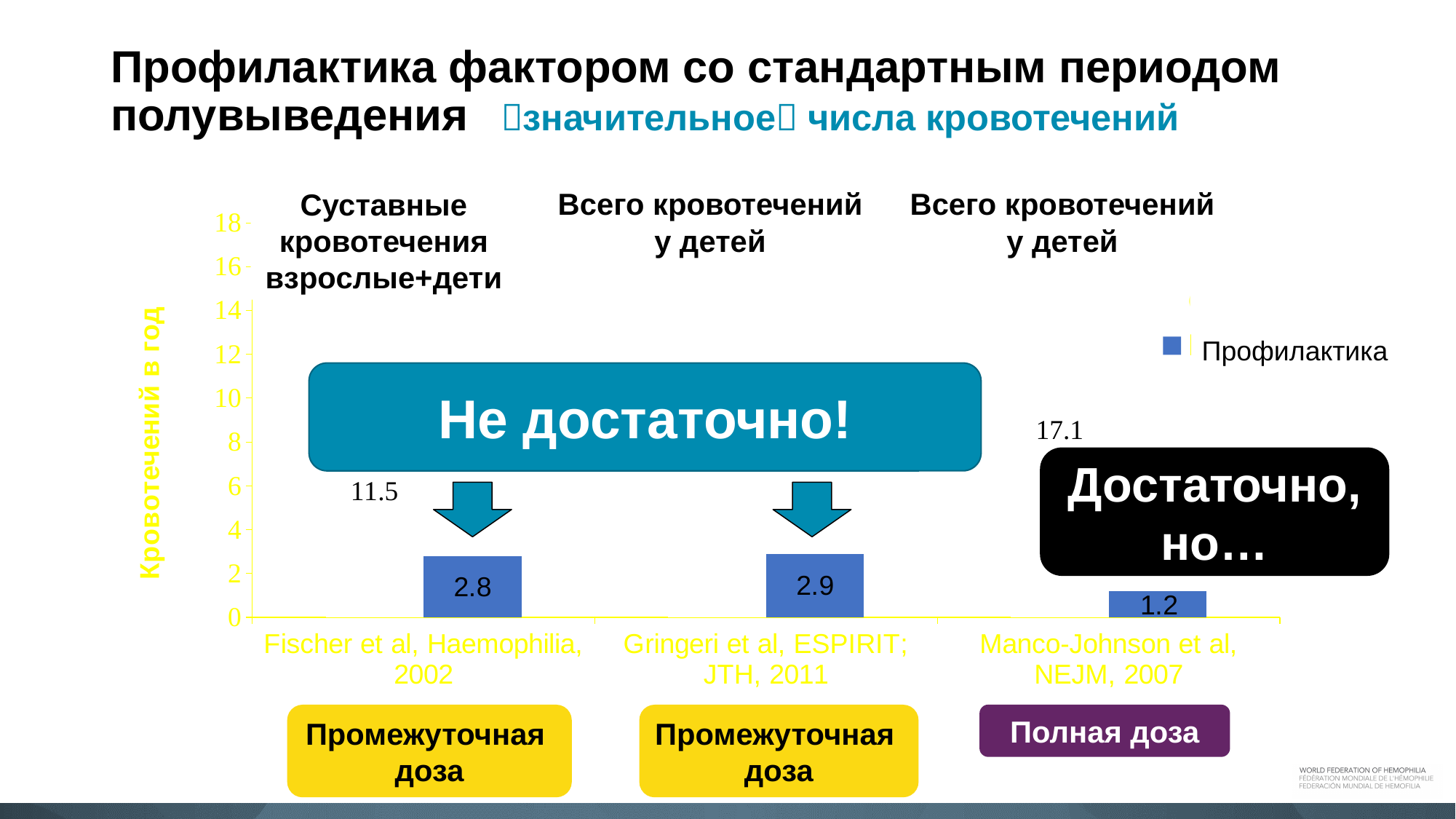
Which study has the lowest Профилактика bar? Manco-Johnson et al, NEJM, 2007 Is the Профилактика value for Fischer et al, Haemophilia, 2002 larger or smaller than the value for Manco-Johnson et al, NEJM, 2007? larger What is the value of the Профилактика bar for Gringeri et al, ESPIRIT; JTH, 2011? 2.9 What is the difference between the Профилактика values for Gringeri et al, ESPIRIT; JTH, 2011 and Manco-Johnson et al, NEJM, 2007? 1.7 What is the difference between the Профилактика values for Fischer et al, Haemophilia, 2002 and Manco-Johnson et al, NEJM, 2007? 1.6 What type of chart is shown on the slide? bar chart What is the value of the Профилактика bar for Fischer et al, Haemophilia, 2002? 2.8 How many studies (categories) are shown on the x axis of the chart? 3 What is the value of the Профилактика bar for Manco-Johnson et al, NEJM, 2007? 1.2 Is the Профилактика value for Manco-Johnson et al, NEJM, 2007 greater or less than 2? less What is the highest tick value shown on the y axis? 18 What is the label of the y axis of the chart? Кровотечений в год